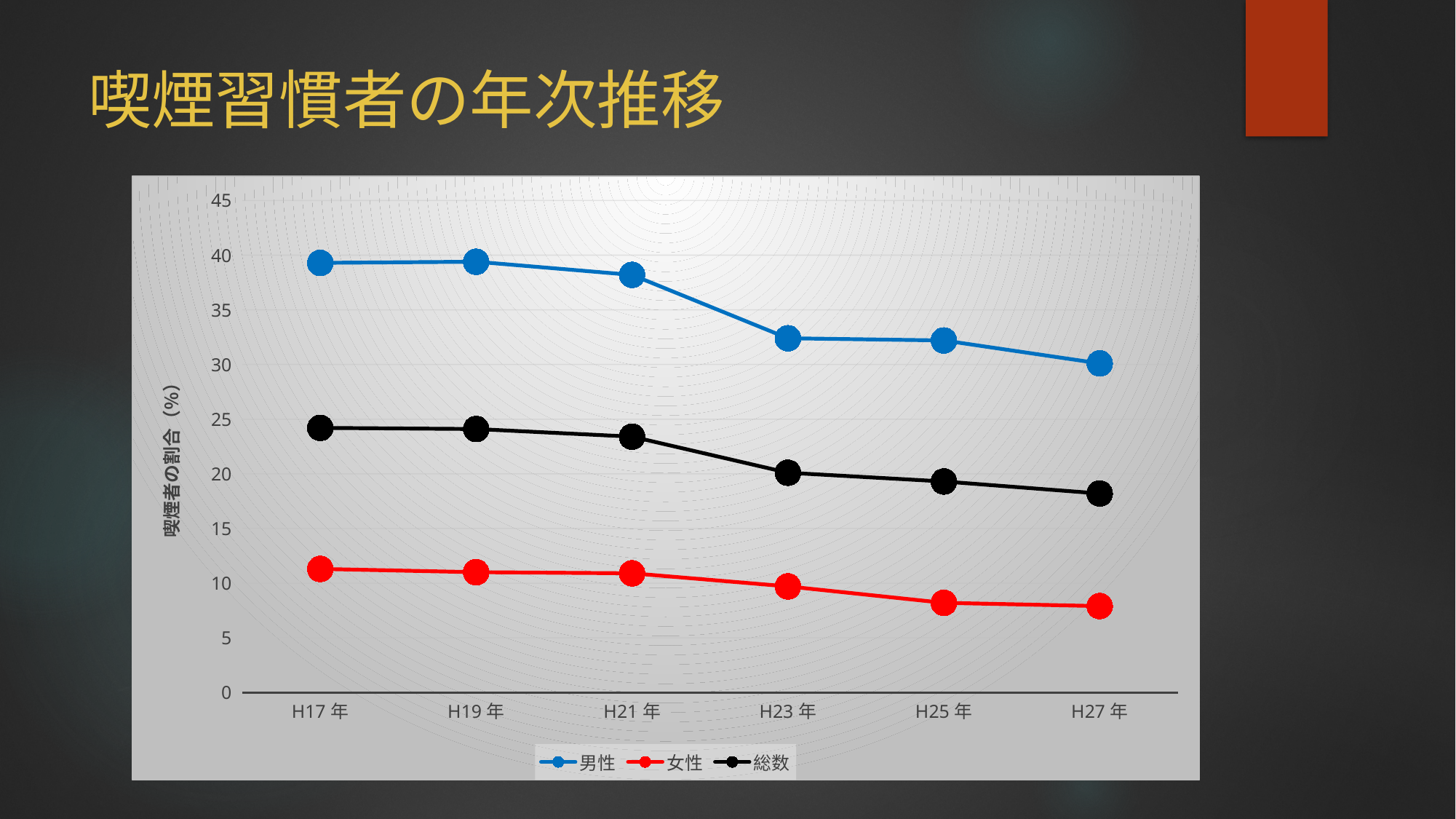
Is the value for 男性 in H27年 greater or less than 35? less In which year is the value for 男性 lowest? H27年 How many years are plotted along the x axis? 6 What is the title of the chart on the slide? 喫煙習慣者の年次推移 What kind of chart is shown on the slide? line chart Is the value for 男性 in H17年 greater or less than 35? greater Is the value for 総数 in H17年 greater or less than 20? greater Do the values for 総数 rise or fall from H17年 to H27年? fall How many series does the legend list? 3 Which is larger for 男性: the value in H21年 or the value in H23年? H21年